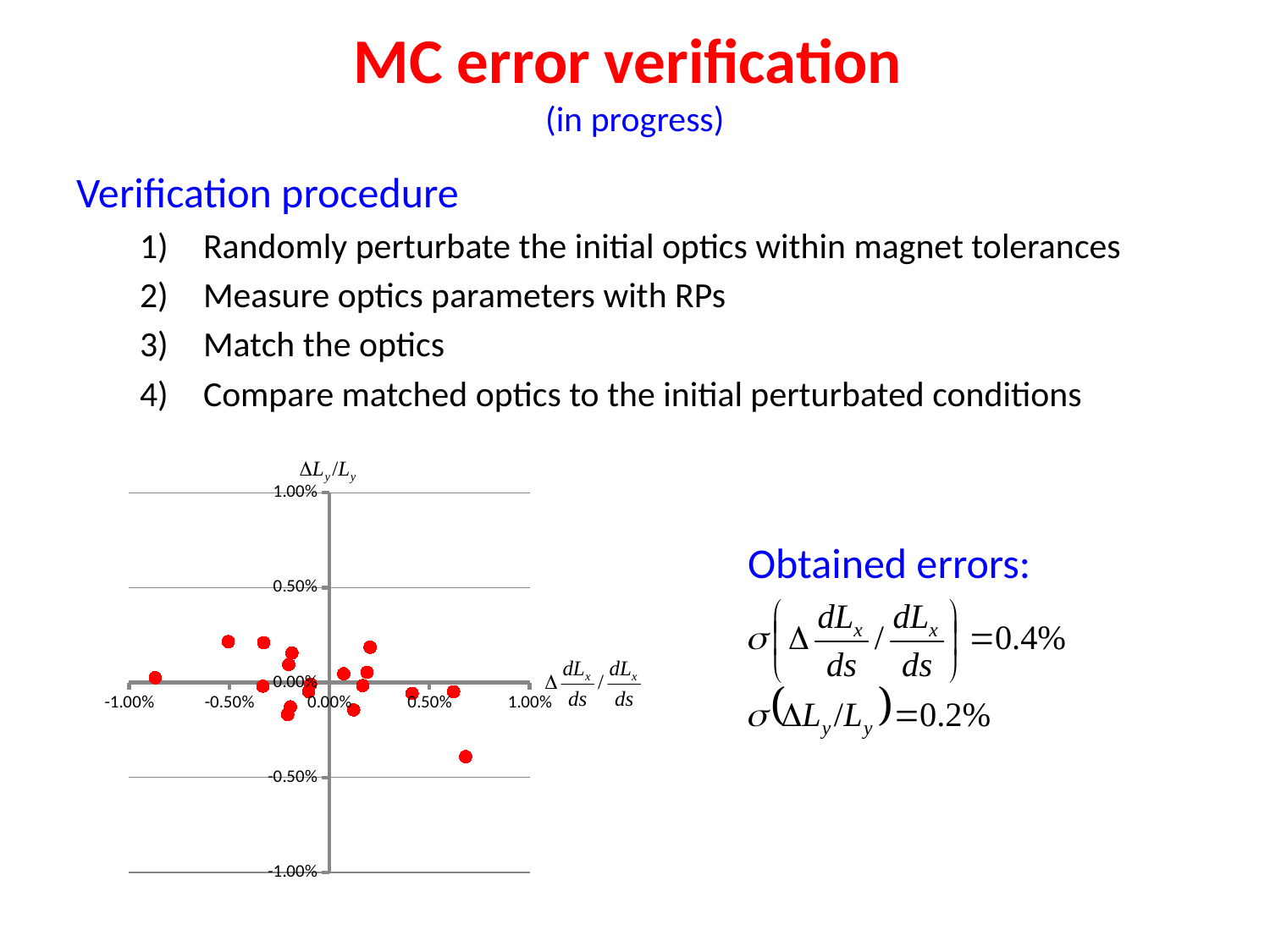
Is the lowest point in the scatter chart located to the right or to the left of the vertical axis (0.00%)? right Is the vertical-axis value of the highest point in the scatter chart greater or less than 0.50%? less What is the highest tick value shown on the vertical axis of the scatter chart? 1.00% Do any points in the scatter chart lie outside the range -1.00% to 1.00% on the vertical axis? No Is the horizontal-axis value of the leftmost point in the scatter chart greater or less than -0.50%? less What is the lowest tick value shown on the horizontal axis of the scatter chart? -1.00% What is the label on the vertical axis of the scatter chart? ΔLy/Ly What kind of chart is shown on the slide? scatter chart What colour are the data points in the scatter chart? red